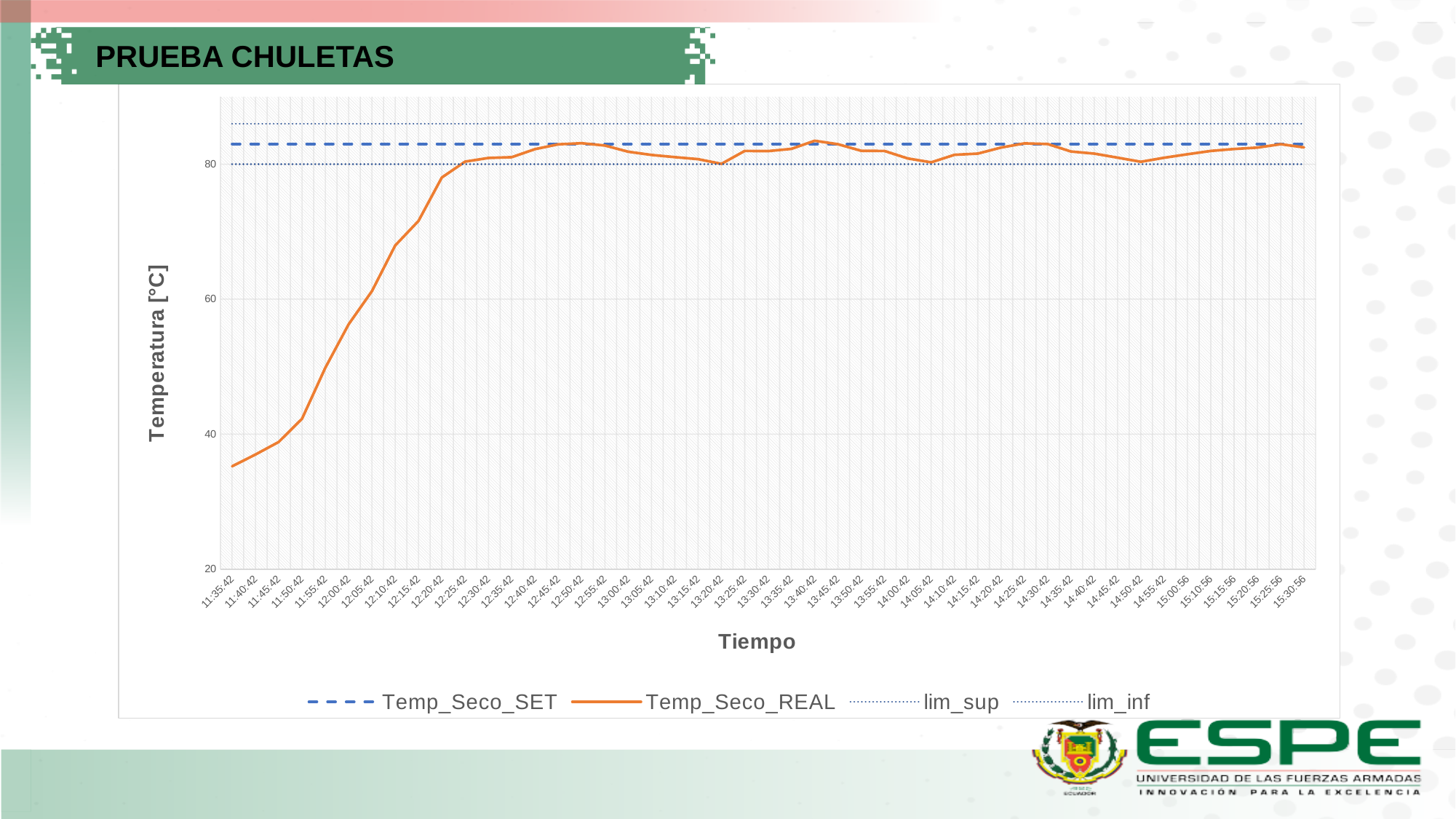
What is the label of the vertical axis? Temperatura [°C] At what temperature does the lim_inf line sit? 80 Is the Temp_Seco_REAL value at 12:10:42 greater or less than 60? greater Which is larger for Temp_Seco_REAL: the value at 11:45:42 or the value at 12:15:42? 12:15:42 What kind of chart is shown on the slide? line chart Is the Temp_Seco_REAL value at 13:40:42 greater or less than 80? greater At which time does Temp_Seco_REAL reach its lowest value? 11:35:42 Is the Temp_Seco_REAL value at 12:00:42 greater or less than 60? less Does Temp_Seco_REAL rise or fall between 11:35:42 and 12:45:42? rise How many series does the legend list? 4 What is the title of the slide containing the chart? PRUEBA CHULETAS